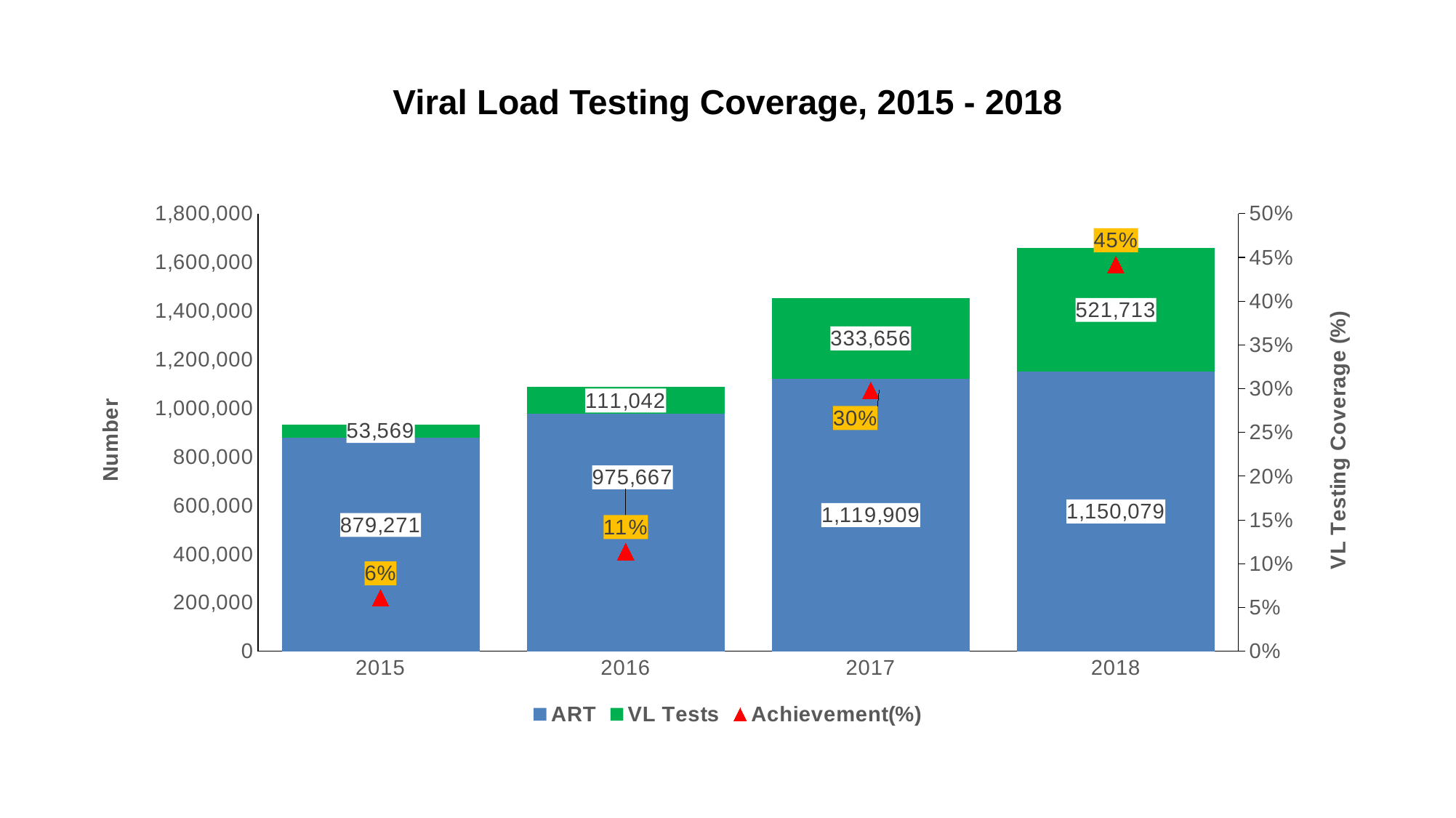
What is the VL Tests value for 2016? 111,042 What is the Achievement(%) value for 2018? 45% Does the Achievement(%) series rise or fall from 2015 to 2018? rise How many years are shown on the x axis? 4 What is the title of the chart? Viral Load Testing Coverage, 2015 - 2018 Which year has the highest ART value? 2018 Which year has the lowest VL Tests value? 2015 Is the Achievement(%) value for 2017 greater or less than the Achievement(%) value for 2016? greater What is the total of the stacked bar for 2015 (ART plus VL Tests)? 932,840 What is the ART value for 2017? 1,119,909 What is the difference between the VL Tests values for 2018 and 2017? 188,057 How many series does the legend list? 3